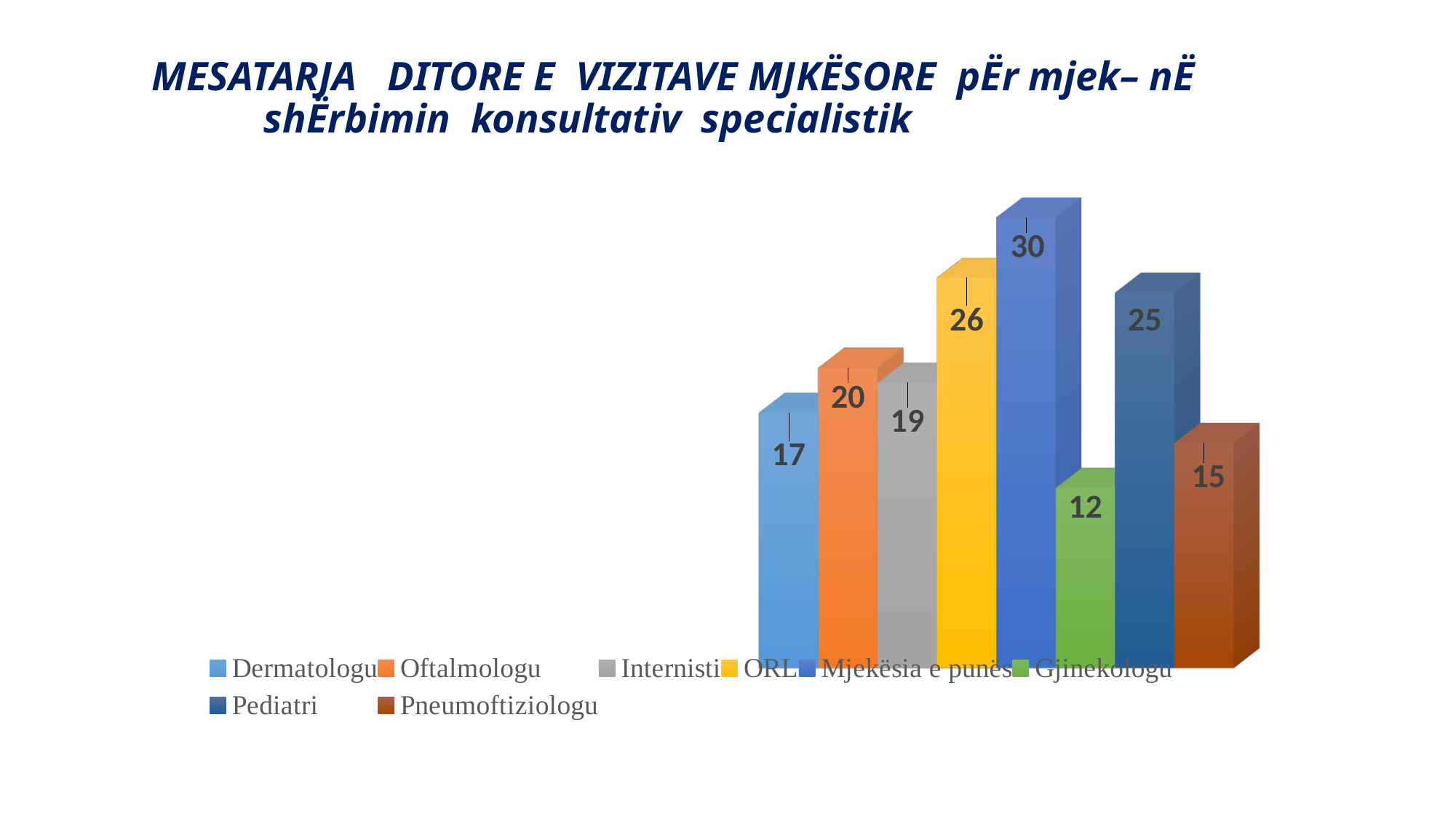
What is the difference between the values for Mjekësia e punës and Gjinekologu? 18 How many entries does the legend list? 8 What is the value for Mjekësia e punës? 30 What is the value for Pneumoftiziologu? 15 Which specialty has the highest value? Mjekësia e punës What is the value for Dermatologu? 17 What kind of chart is shown on the slide? Bar chart What is the value for ORL? 26 What is the difference between the values for Pediatri and Oftalmologu? 5 How many bars are plotted in the chart? 8 Which specialty has the lowest value? Gjinekologu Which is larger, the value for Oftalmologu or the value for Internisti? Oftalmologu